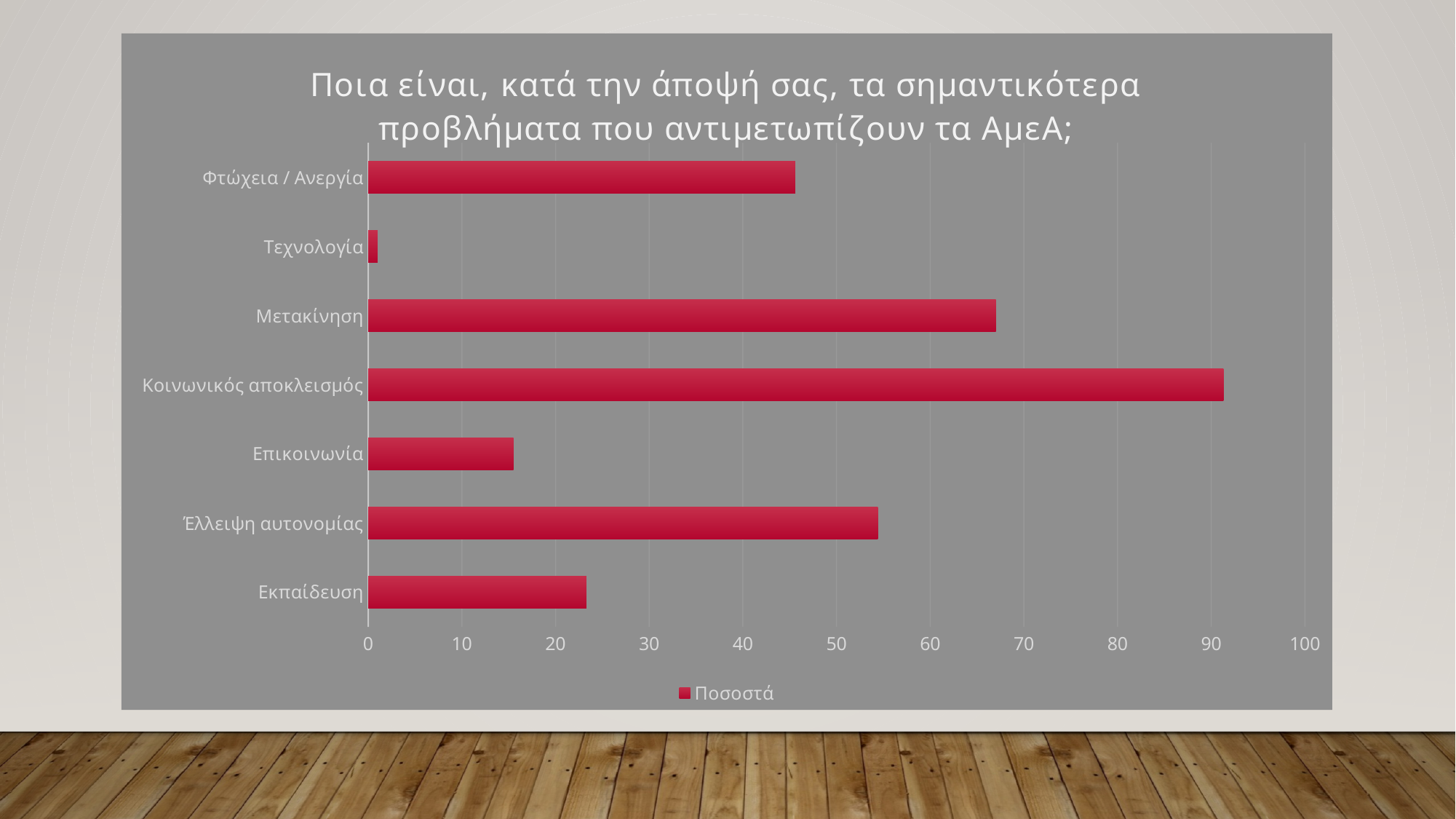
How many categories are plotted in the chart? 7 What kind of chart is shown on the slide? bar chart Is the value for Εκπαίδευση greater or less than 30? less Which category has the lowest value? Τεχνολογία Is the value for Μετακίνηση greater or less than 60? greater Is the value for Κοινωνικός αποκλεισμός greater or less than 90? greater How many series does the legend list? 1 Which category has the highest value? Κοινωνικός αποκλεισμός Which is larger, the value for Έλλειψη αυτονομίας or the value for Φτώχεια / Ανεργία? Έλλειψη αυτονομίας Which is larger, the value for Εκπαίδευση or the value for Επικοινωνία? Εκπαίδευση What is the name of the series shown in the legend? Ποσοστά